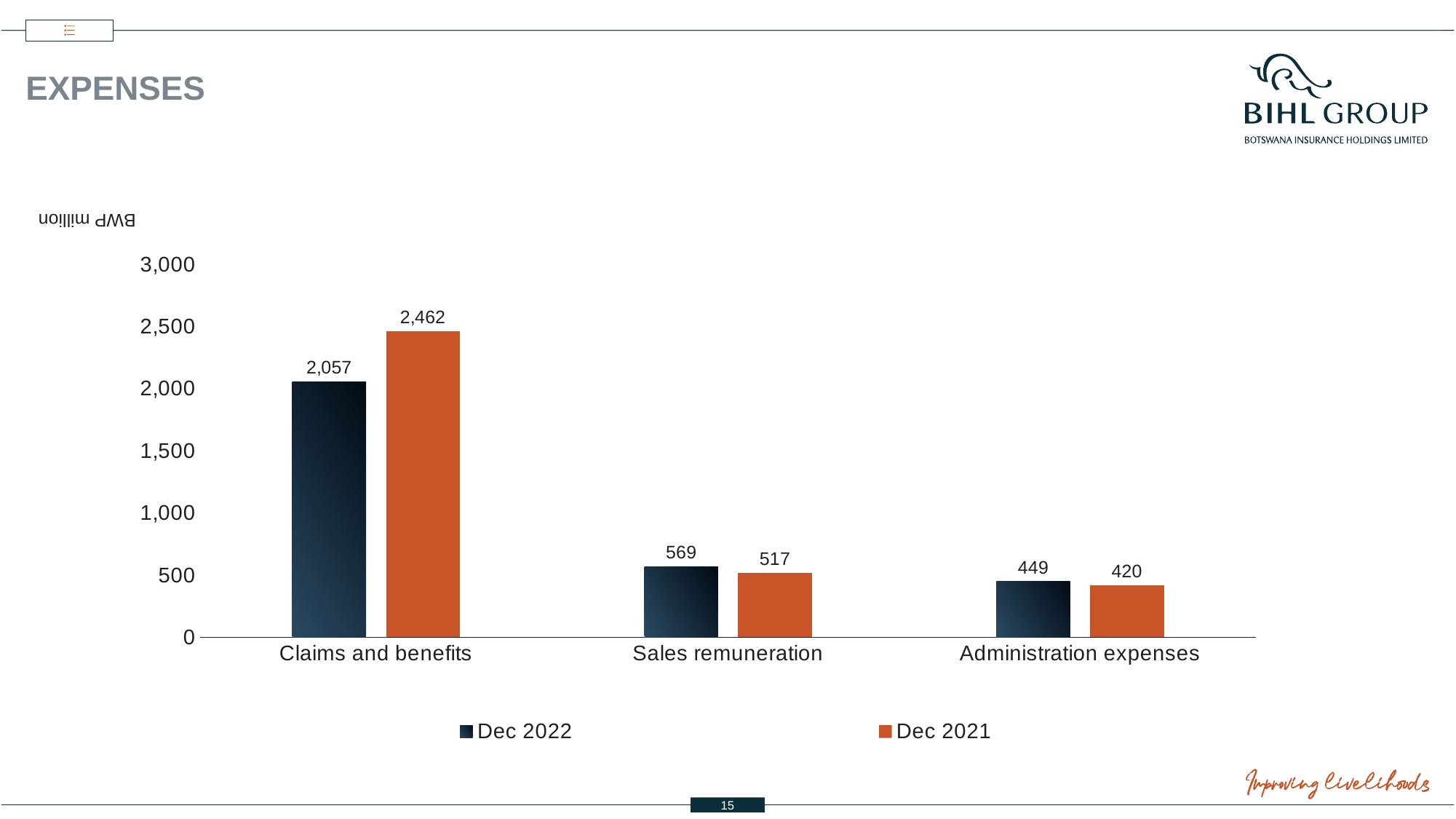
What is the Dec 2022 value for Claims and benefits? 2,057 How many categories are shown on the x axis? 3 What is the Dec 2022 value for Administration expenses? 449 What is the difference between the Dec 2022 and Dec 2021 values for Sales remuneration? 52 What is the difference between the Dec 2021 and Dec 2022 values for Claims and benefits? 405 How many series does the legend list? 2 Is the Dec 2022 value for Sales remuneration greater or less than 500? greater Which category has the highest Dec 2021 value? Claims and benefits What kind of chart is shown on the slide? Bar chart Which is larger for Administration expenses: Dec 2022 or Dec 2021? Dec 2022 What is the Dec 2021 value for Sales remuneration? 517 Which category has the lowest Dec 2022 value? Administration expenses